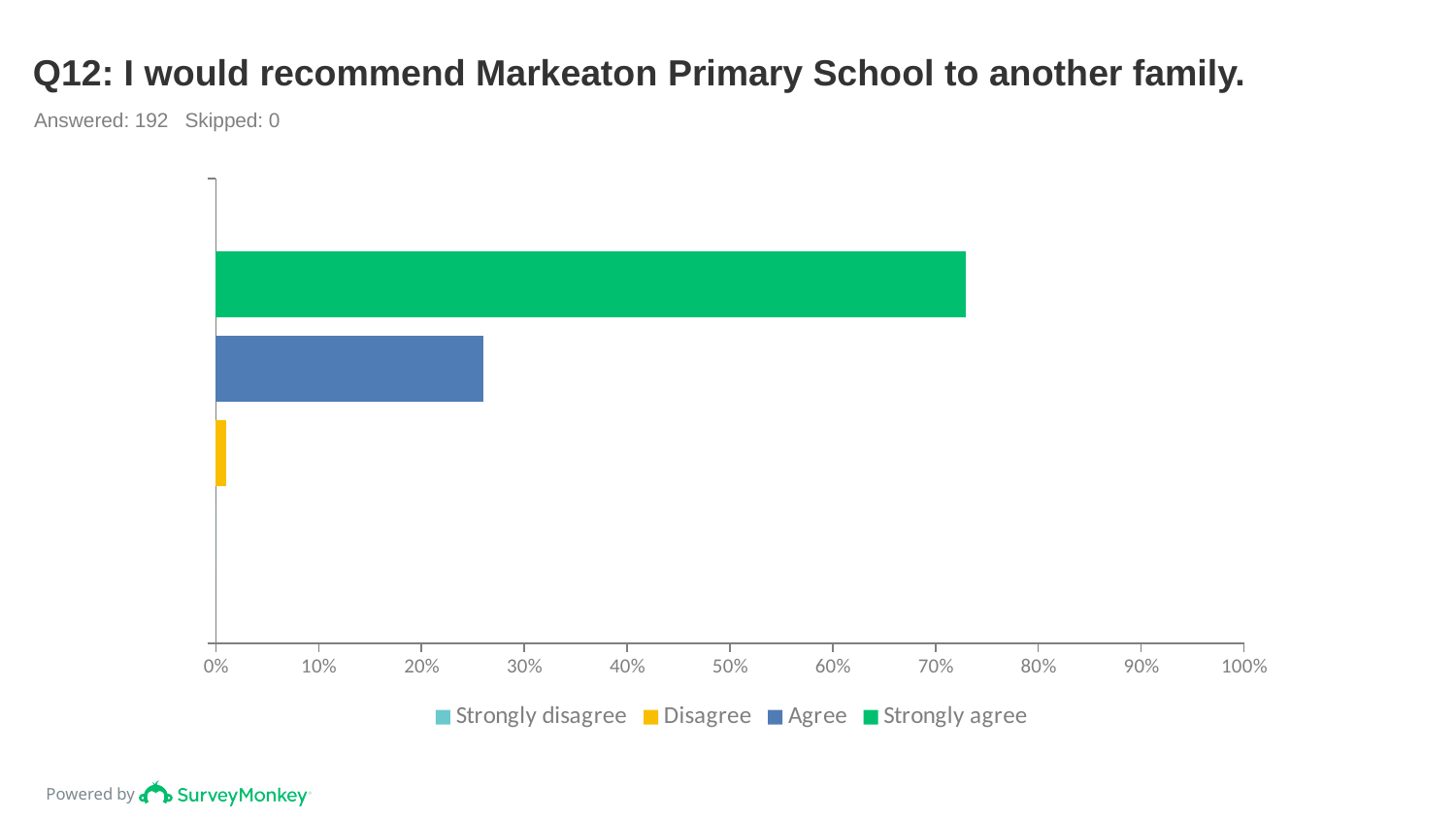
Which response has the longest bar? Strongly agree How many series does the legend list? 4 Is the value for Disagree greater or less than 10%? less Is the value for Strongly agree greater or less than 70%? greater How many respondents answered this question according to the slide? 192 Which is larger, the value for Agree or the value for Strongly agree? Strongly agree Is the value for Agree greater or less than 20%? greater Which is larger, the value for Disagree or the value for Agree? Agree What is the title of the chart? Q12: I would recommend Markeaton Primary School to another family. What kind of chart is shown on the slide? Bar chart